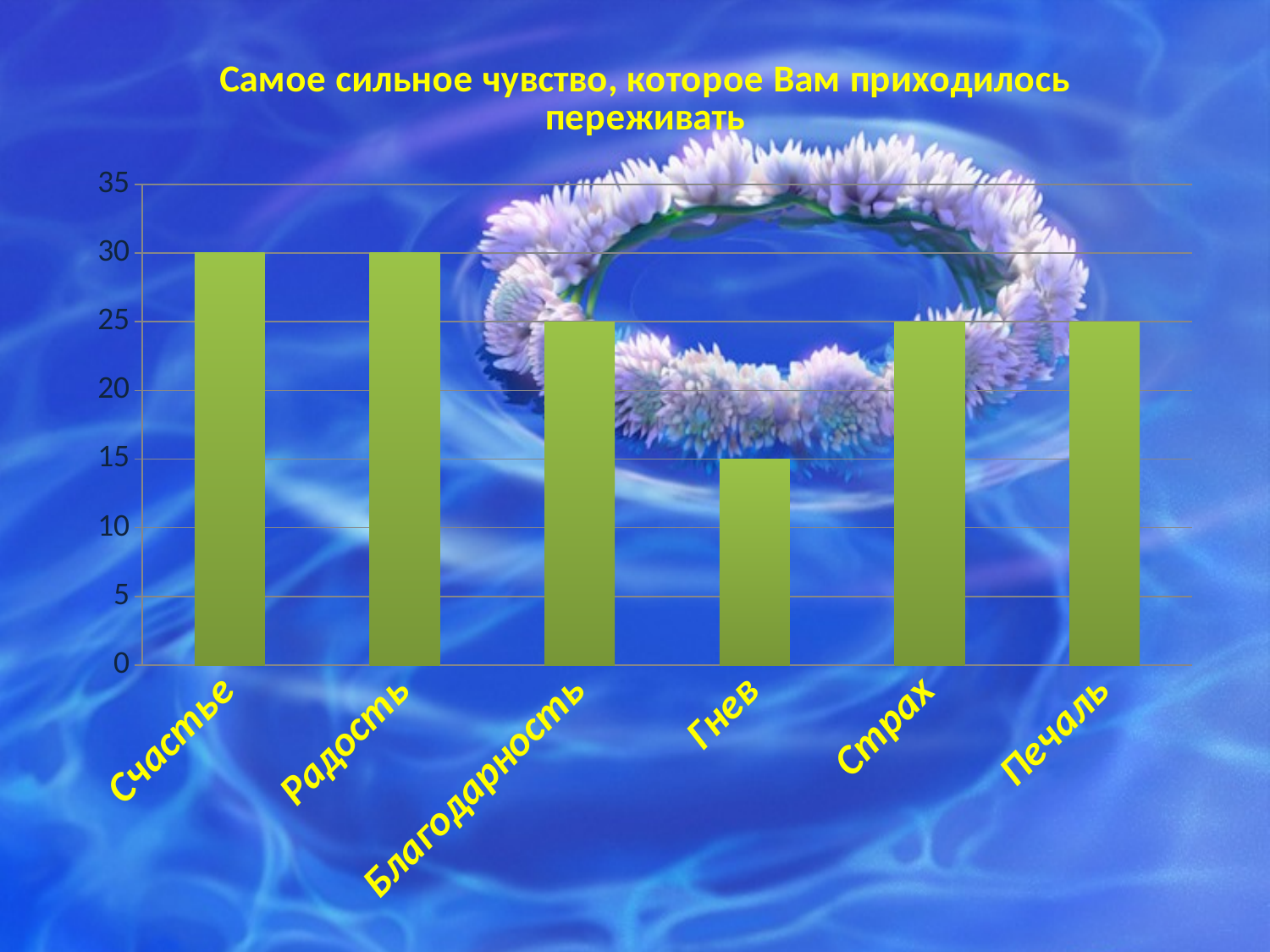
What type of chart is shown on the slide? bar chart What is the value for Счастье? 30 Which is larger, the value for Радость or the value for Страх? Радость Is the value for Страх greater or less than 20? greater What is the maximum value shown on the vertical axis? 35 What is the value for Гнев? 15 Which category has the lowest value? Гнев What is the difference between the values for Счастье and Гнев? 15 What is the title of the chart? Самое сильное чувство, которое Вам приходилось переживать What is the value for Печаль? 25 What is the value for Благодарность? 25 How many categories are shown on the x axis of the chart? 6